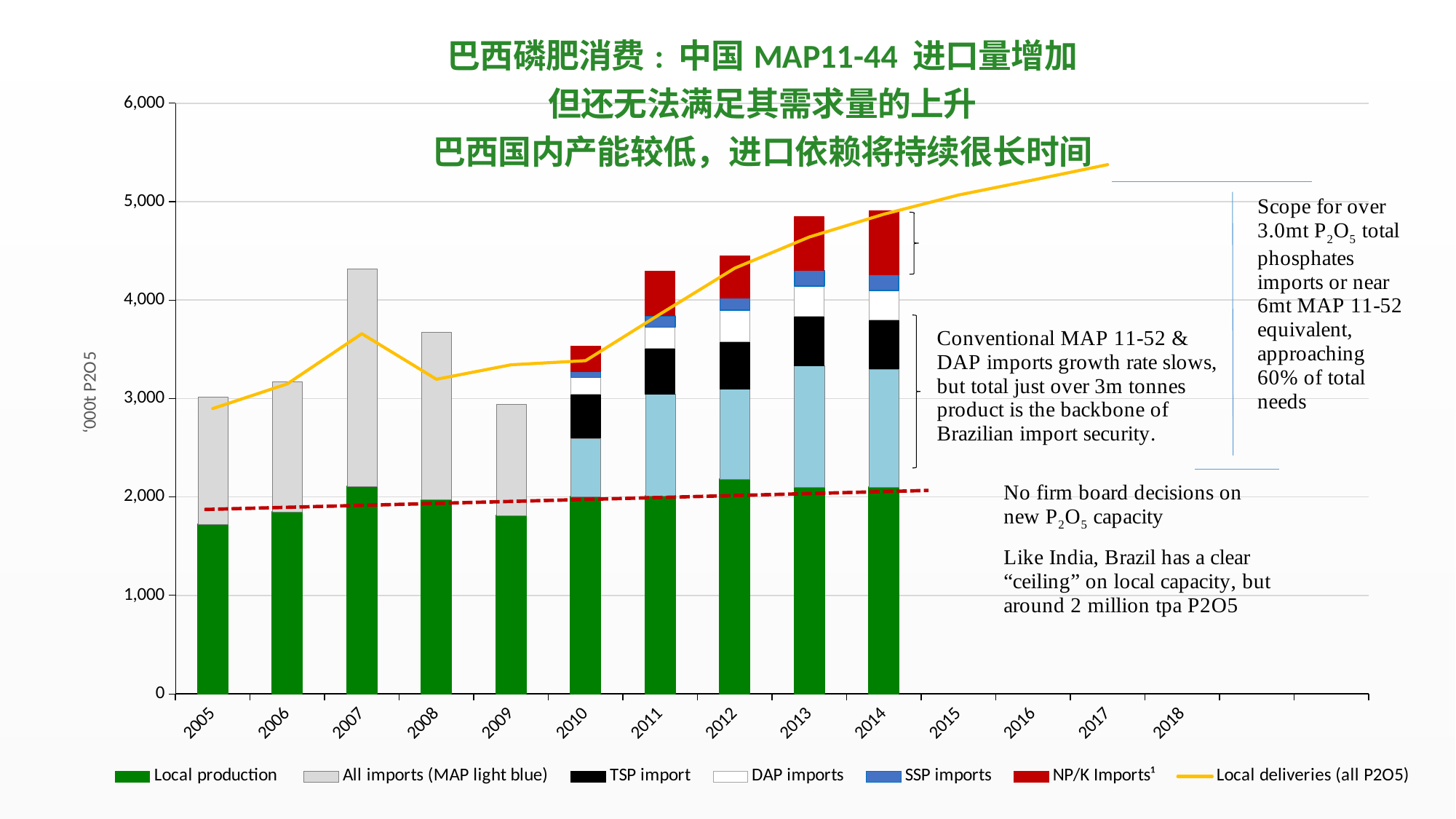
What kind of chart is shown on the slide? Stacked bar chart with a line What is the label on the y axis? '000t P2O5 Which series is shown in red in the legend? NP/K Imports Which year has the larger total stacked bar, 2007 or 2008? 2007 Does the Local deliveries (all P2O5) line generally rise or fall from 2005 to 2017? rise Is the Local production value for 2009 greater or less than 2,000? less Is the Local deliveries (all P2O5) line value for 2017 greater or less than 5,000? greater Is the total stacked bar for 2009 greater or less than 3,000? less How many years have stacked bars plotted? 10 How many series does the legend list? 7 How many year labels are shown on the x axis? 14